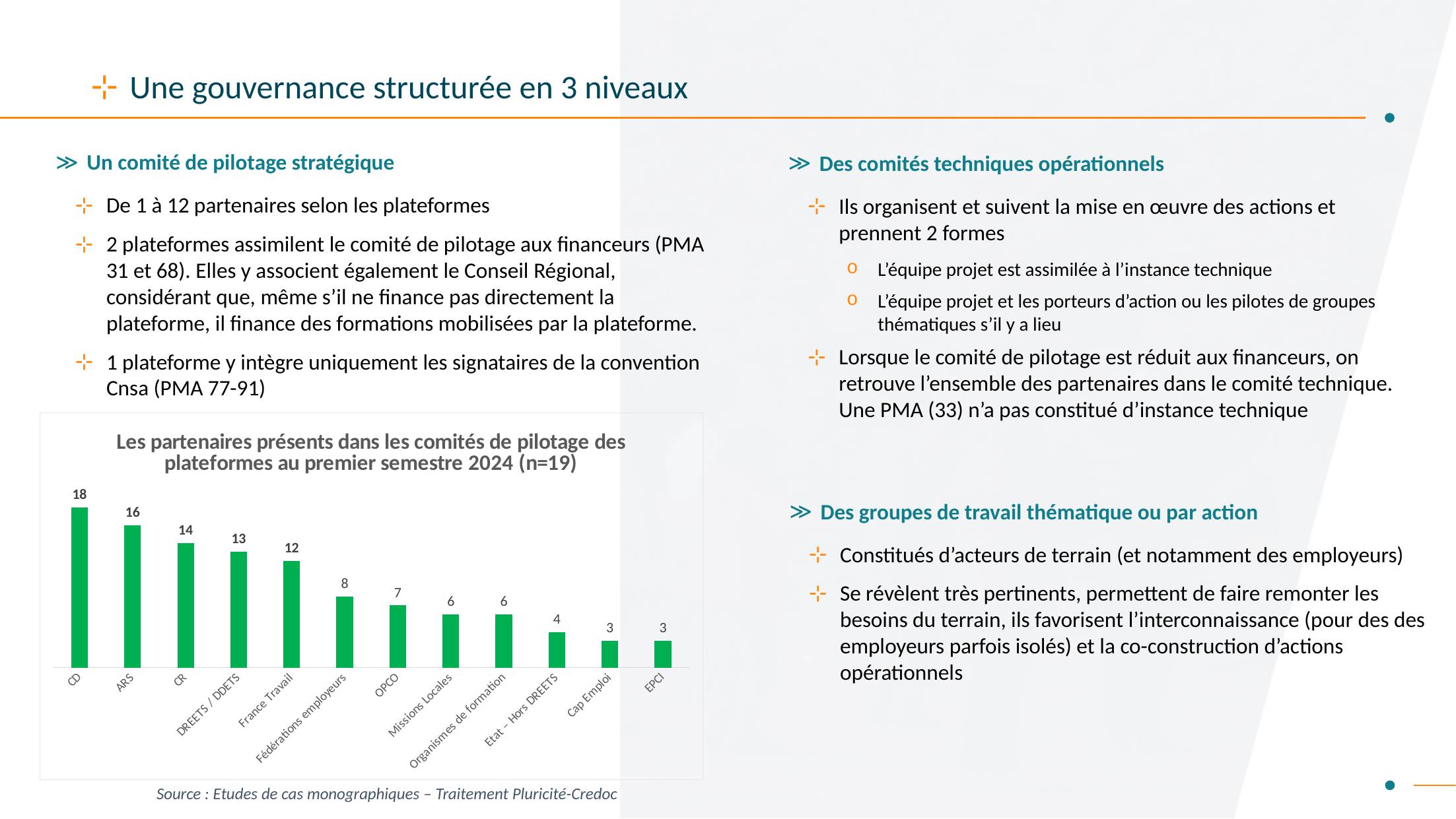
Which is larger, the value for OPCO or the value for DREETS / DDETS? DREETS / DDETS How many categories are shown in the chart? 12 What is the value for Etat – Hors DREETS? 4 What is the value for France Travail? 12 What is the difference between the values for CD and EPCI? 15 Do the values rise or fall from left to right along the x axis? Fall What is the title of the chart? Les partenaires présents dans les comités de pilotage des plateformes au premier semestre 2024 (n=19) What is the value for Fédérations employeurs? 8 What is the difference between the values for ARS and CR? 2 What is the value for CD? 18 Which category has the highest value? CD What kind of chart is shown on the slide? Bar chart